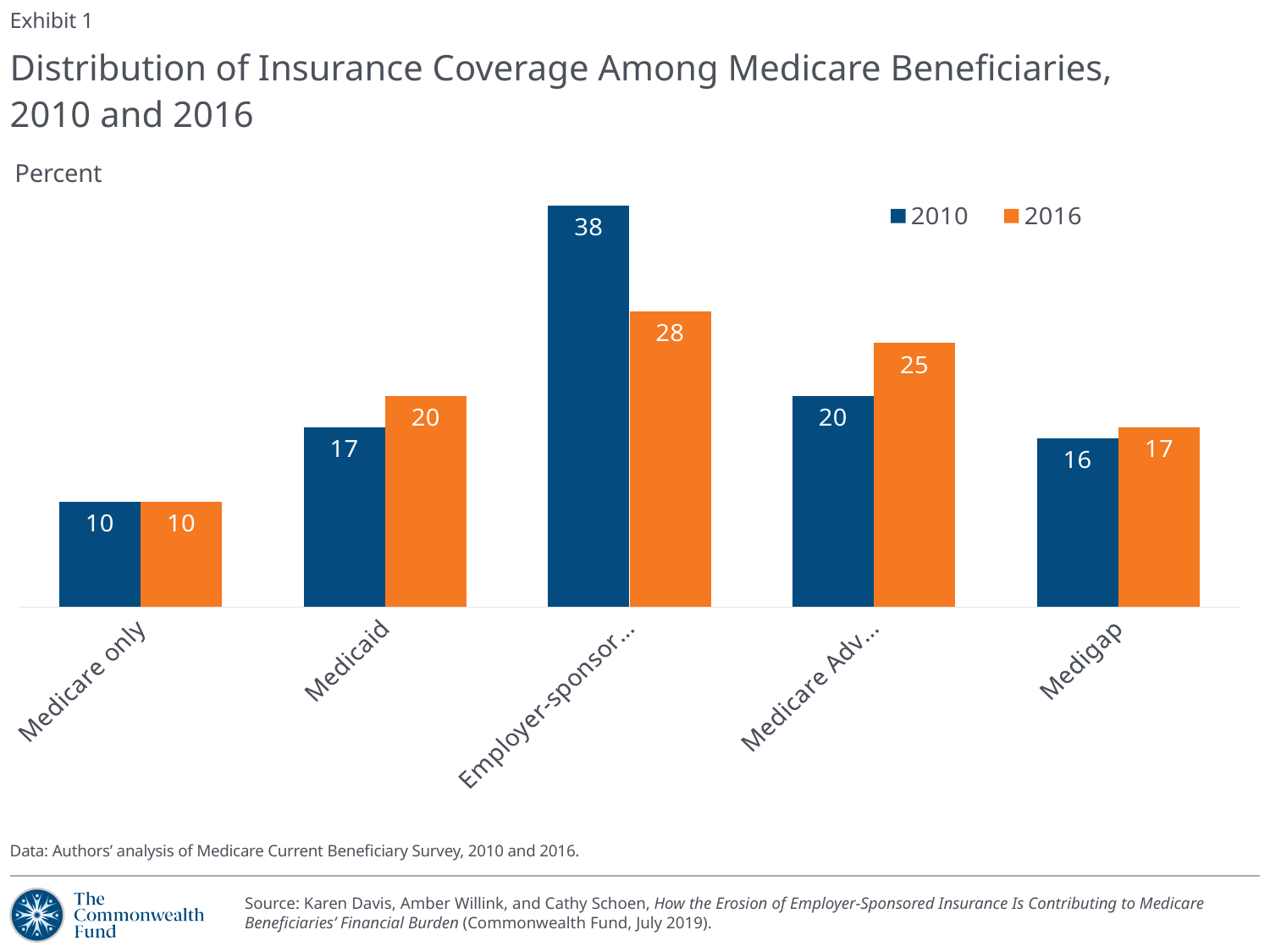
Which category has the highest 2010 value? Employer-sponsor... What is the 2010 value for Medicaid? 17 What is the difference between the 2016 and 2010 values for the Medicare Adv... category? 5 What is the 2016 value for Medigap? 17 Which is larger for Medicaid: the 2010 value or the 2016 value? 2016 What kind of chart is shown on the slide? Bar chart Which category has the lowest 2016 value? Medicare only How many series does the legend list? 2 What is the difference between the 2010 and 2016 values for the Employer-sponsor... category? 10 How many categories are shown on the x axis? 5 Which colour represents the 2016 series in the legend? Orange What is the 2016 value for Medicare only? 10